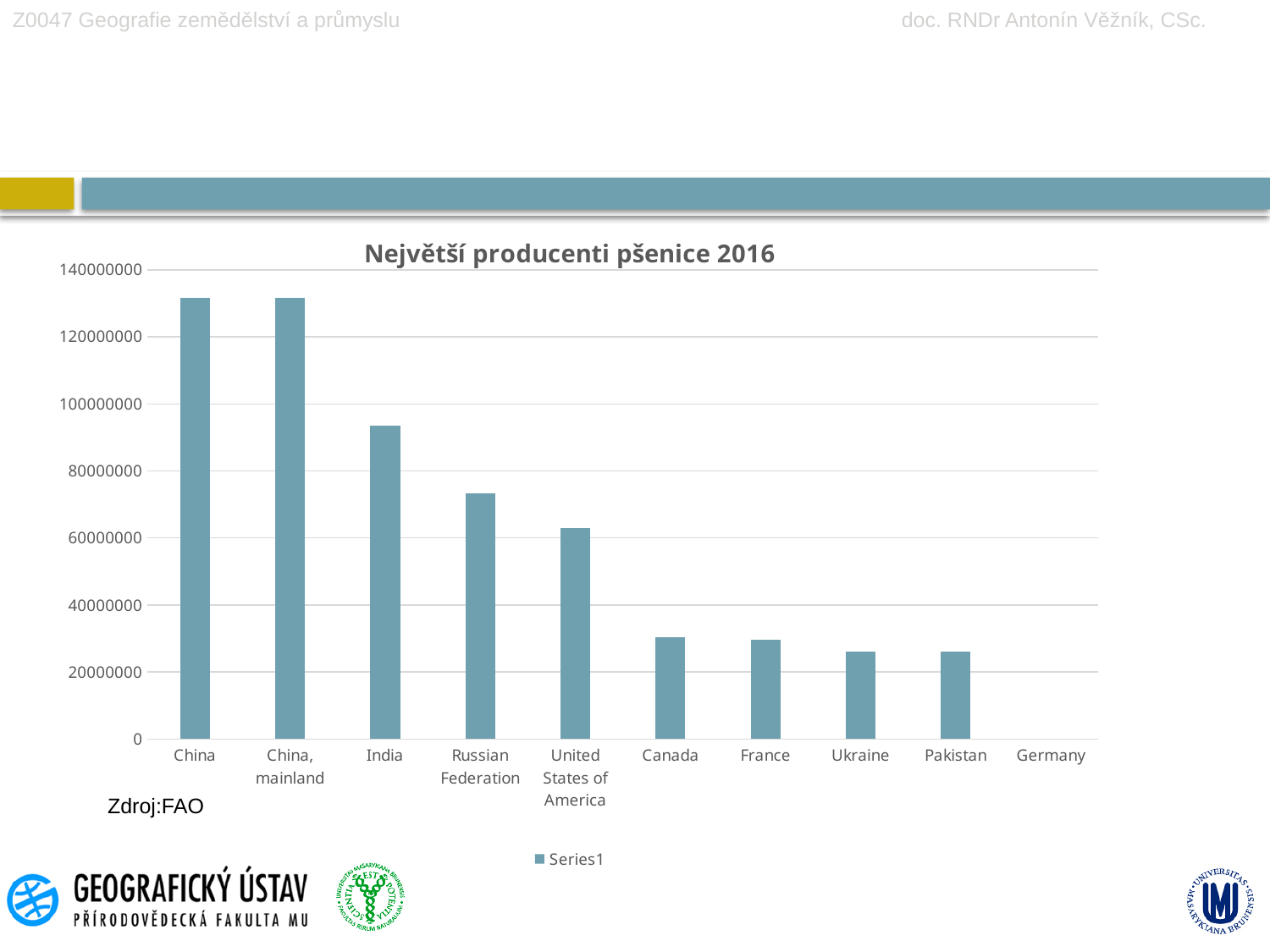
Which has a larger value, United States of America or Canada? United States of America Is the value for China greater or less than 120000000? greater How many categories are shown on the x axis of the chart? 10 Which has a larger value, India or Russian Federation? India Is the value for Ukraine greater or less than 20000000? greater Do the values generally rise or fall from left to right along the x axis? fall How many series does the legend list? 1 What is the title of the chart? Největší producenti pšenice 2016 Is the value for Russian Federation greater or less than 80000000? less What kind of chart is shown on the slide? bar chart